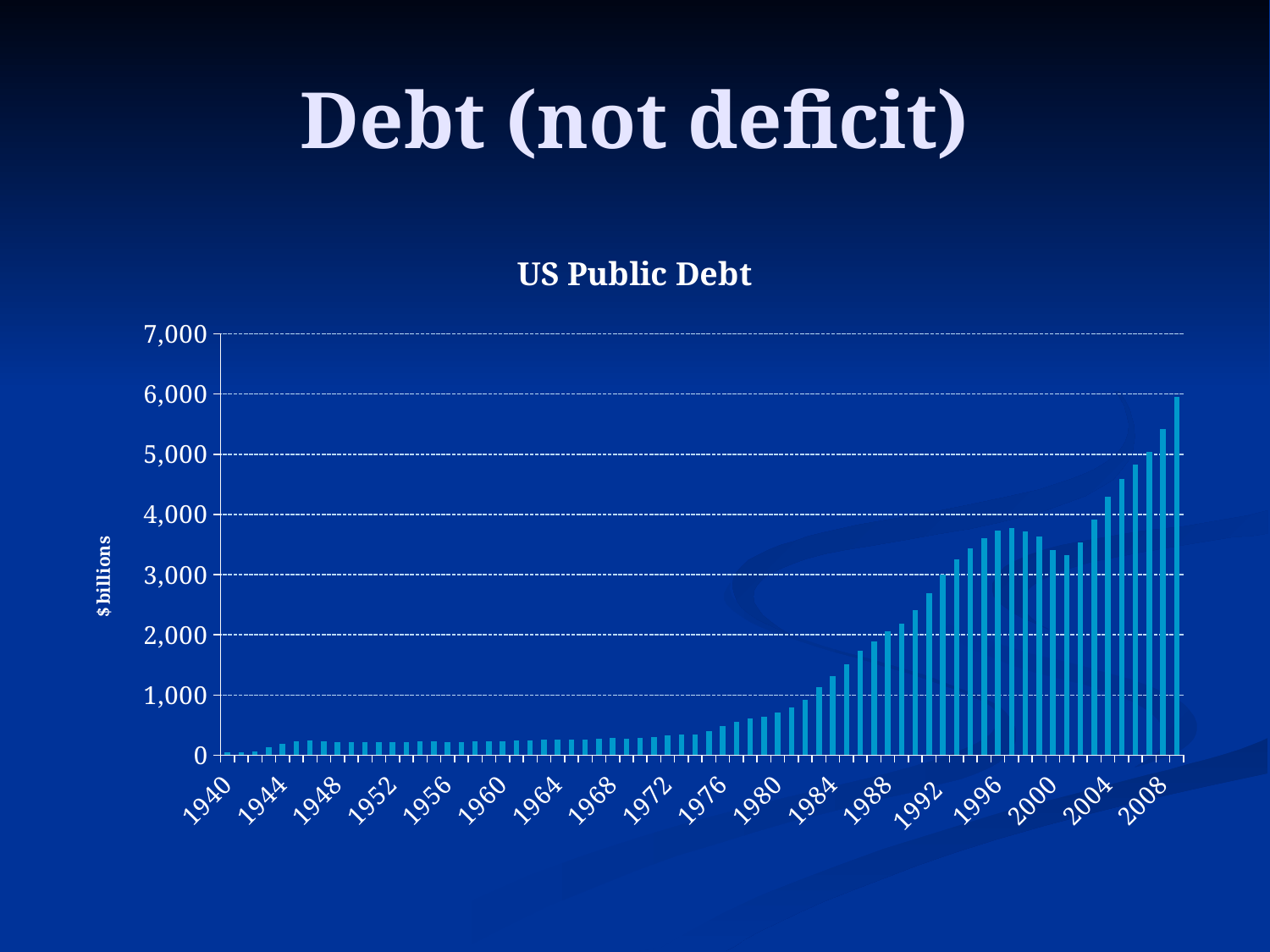
Is the value for 1960 greater or less than 1,000? less Is the highest value on the chart greater or less than 5,000? greater Which year has the larger value, 1980 or 2000? 2000 What kind of chart is shown on the slide? bar chart Which year has the larger value, 1940 or 1944? 1944 What is the title of the chart? US Public Debt What is the label on the vertical axis of the chart? $ billions Overall, do the values rise or fall from 1940 to the right end of the x axis? rise Is the value for 2008 greater or less than 4,000? greater